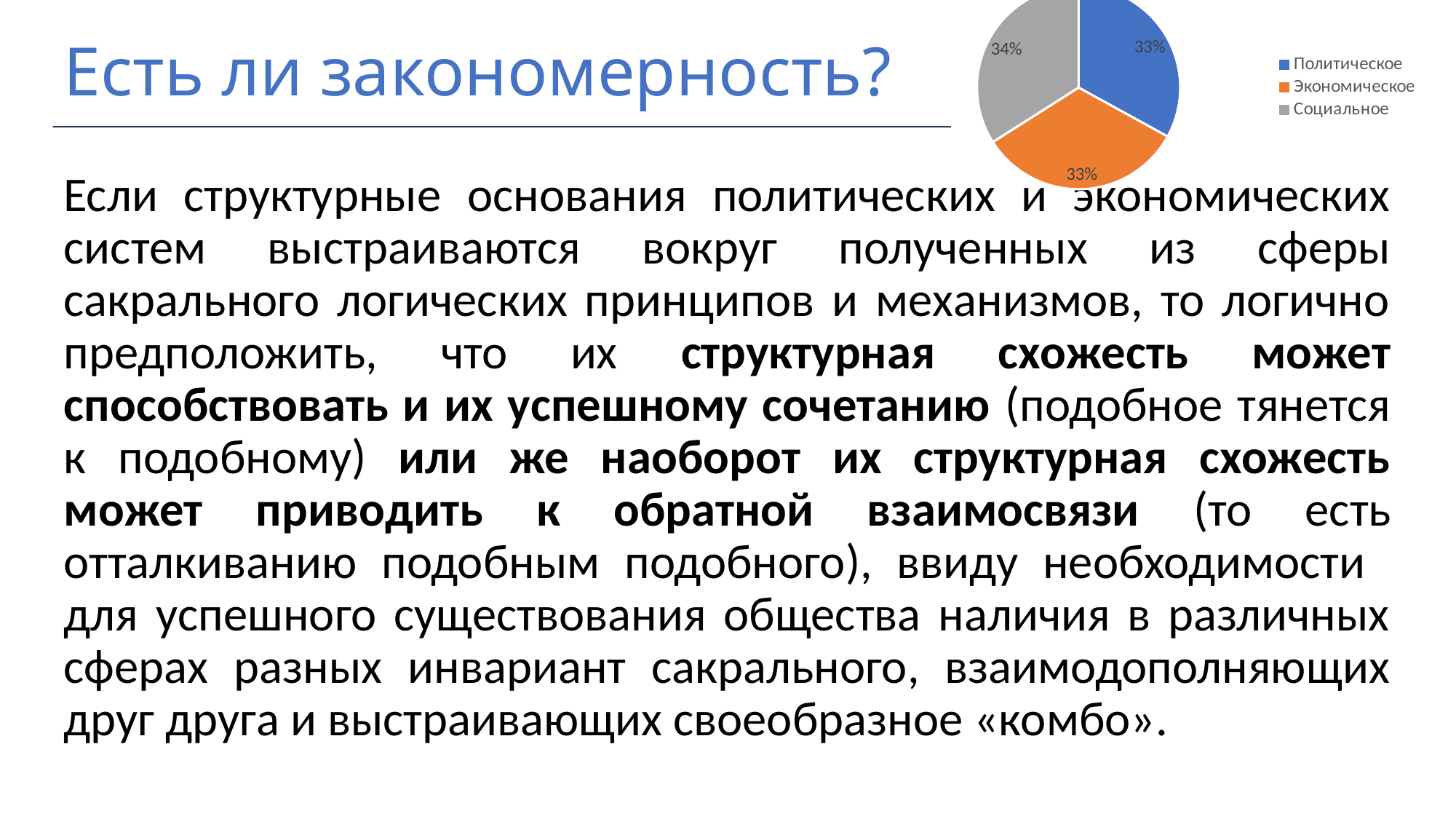
What share of the pie chart does Экономическое account for? 33% What share of the pie chart does Социальное account for? 34% By how many percentage points does the Социальное slice exceed the Политическое slice? 1 Is the share for Социальное greater or less than the share for Экономическое? greater Which legend entry is shown in gray in the pie chart? Социальное How many slices does the pie chart have? 3 What colour is the Экономическое slice in the pie chart? Orange What share of the pie chart does Политическое account for? 33% Which category has the largest slice in the pie chart? Социальное How many entries does the legend of the pie chart list? 3 What kind of chart is shown on the slide? Pie chart